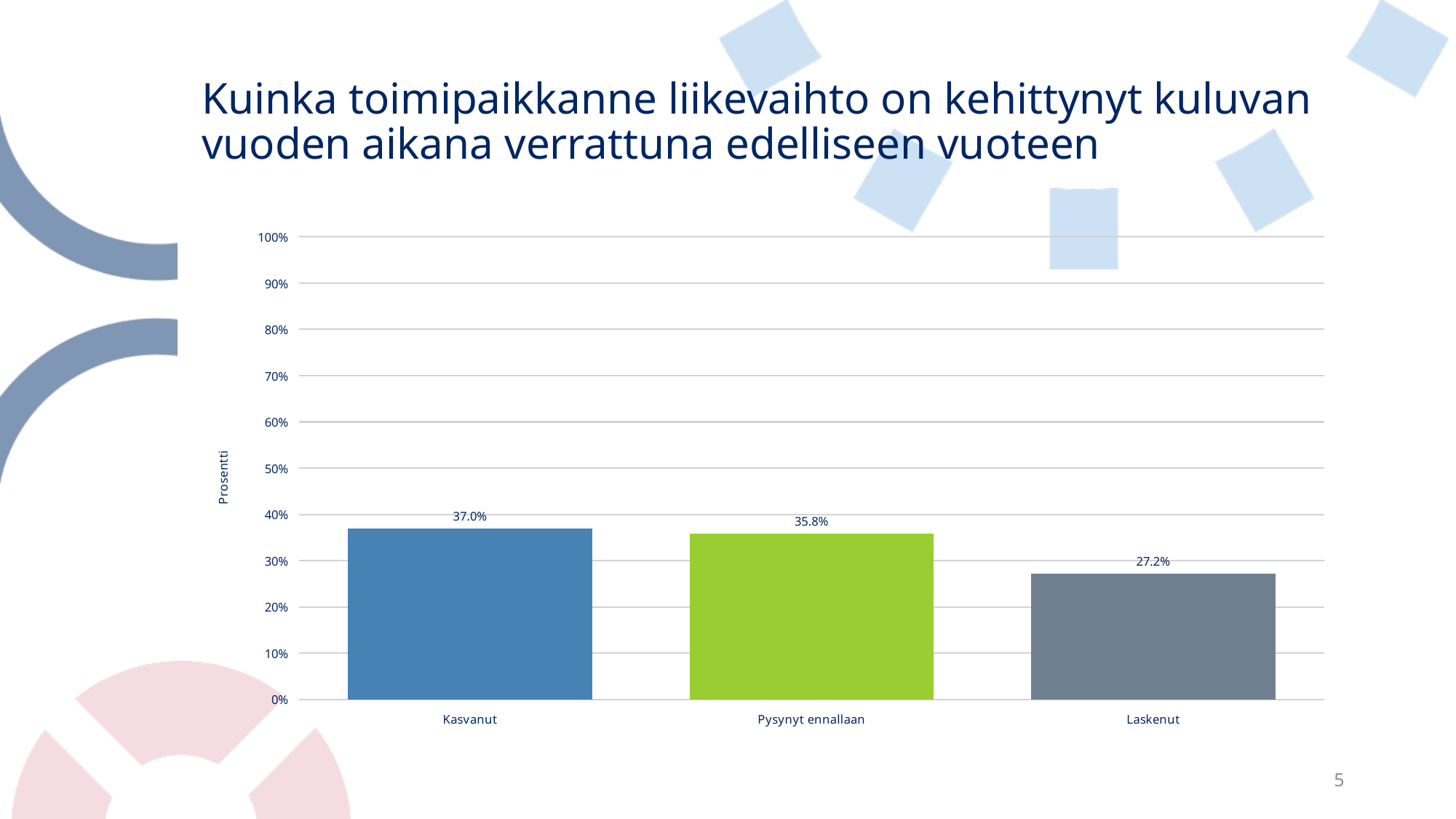
What is the label of the vertical axis? Prosentti What is the difference between the values for Pysynyt ennallaan and Laskenut? 8.6% Is the value for Laskenut greater or less than 30%? less What is the value for Pysynyt ennallaan? 35.8% Which category has the lowest value? Laskenut What is the value for Laskenut? 27.2% What is the difference between the values for Kasvanut and Laskenut? 9.8% Which is larger, the value for Pysynyt ennallaan or the value for Laskenut? Pysynyt ennallaan How many categories are shown on the x axis? 3 What is the value for Kasvanut? 37.0% Which category has the highest value? Kasvanut What kind of chart is shown on the slide? bar chart